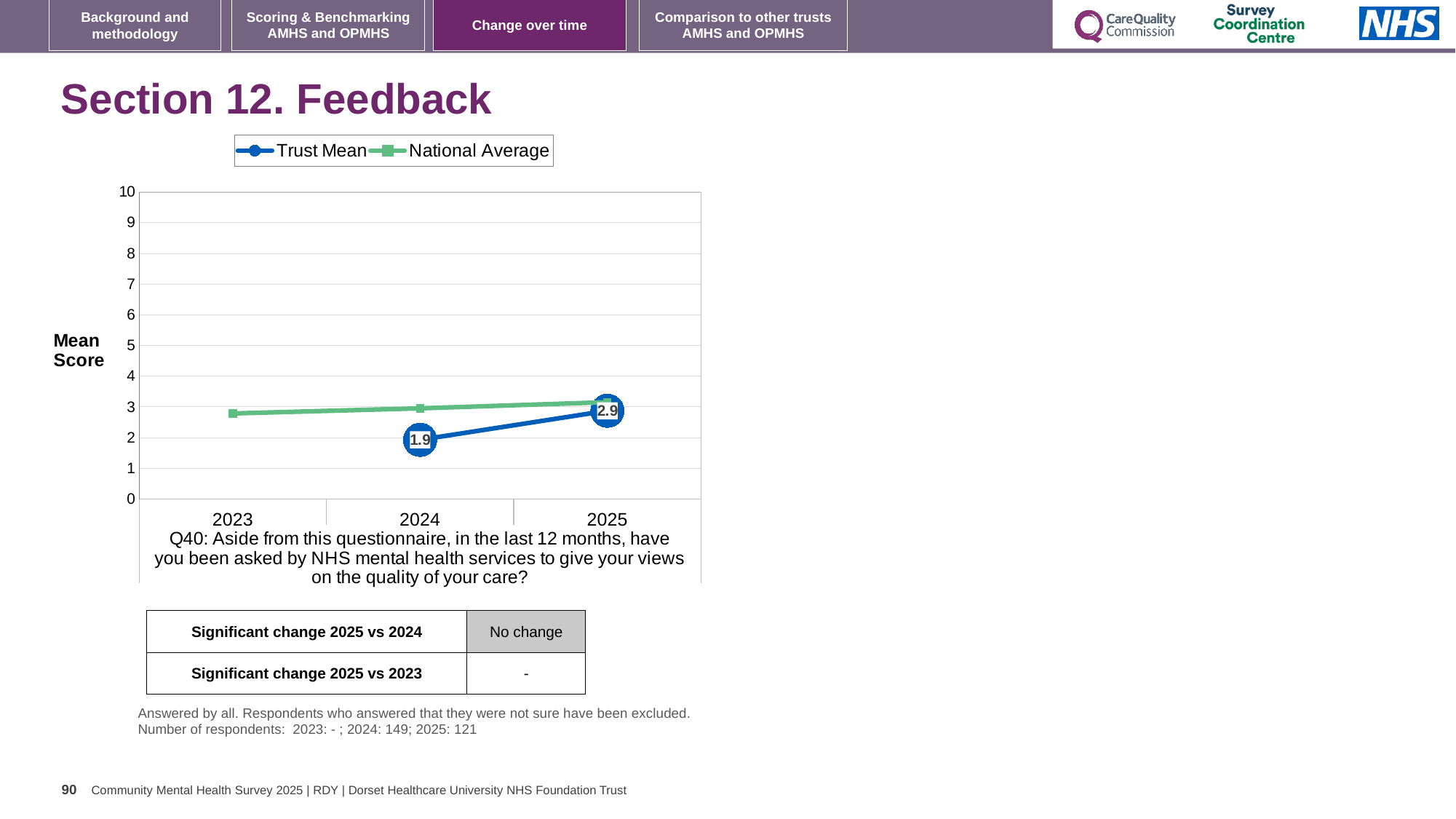
In which year is the Trust Mean highest? 2025 How many years are shown on the x axis? 3 What is the label on the y axis of the chart? Mean Score By how much did the Trust Mean change from 2024 to 2025? 1.0 In 2024, which is larger: the Trust Mean or the National Average? National Average Is the National Average value for 2024 greater or less than 2? greater How many series does the legend list? 2 Does the Trust Mean rise or fall from 2024 to 2025? rise What is the Trust Mean value for 2024? 1.9 Is the National Average value for 2023 greater or less than 5? less What is the Trust Mean value for 2025? 2.9 What kind of chart is shown on the slide? line chart